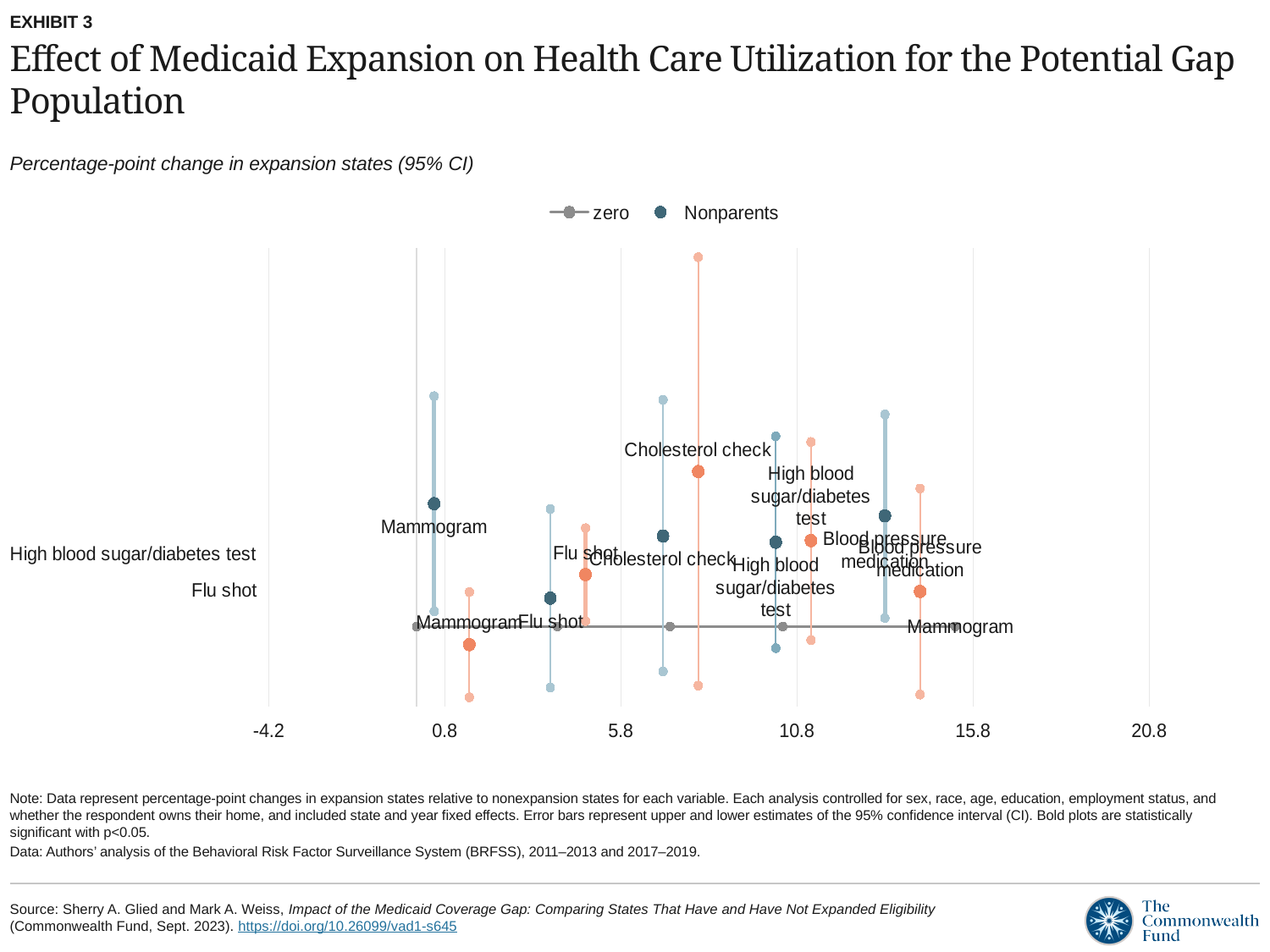
What are the two entries shown in the chart's legend? zero and Nonparents What kind of chart is shown on the slide? Dot plot with error bars Which measure has the lowest Nonparents value? Flu shot What is the title of the chart on the slide? Effect of Medicaid Expansion on Health Care Utilization for the Potential Gap Population How many entries does the chart's legend list? 2 How many health care utilization measures are labeled for the Nonparents series? 5 Which measure has the highest Nonparents value? Mammogram For the Nonparents series, which is larger: the value for Cholesterol check or the value for Flu shot? Cholesterol check What is the lowest value labeled on the chart's x axis? -4.2